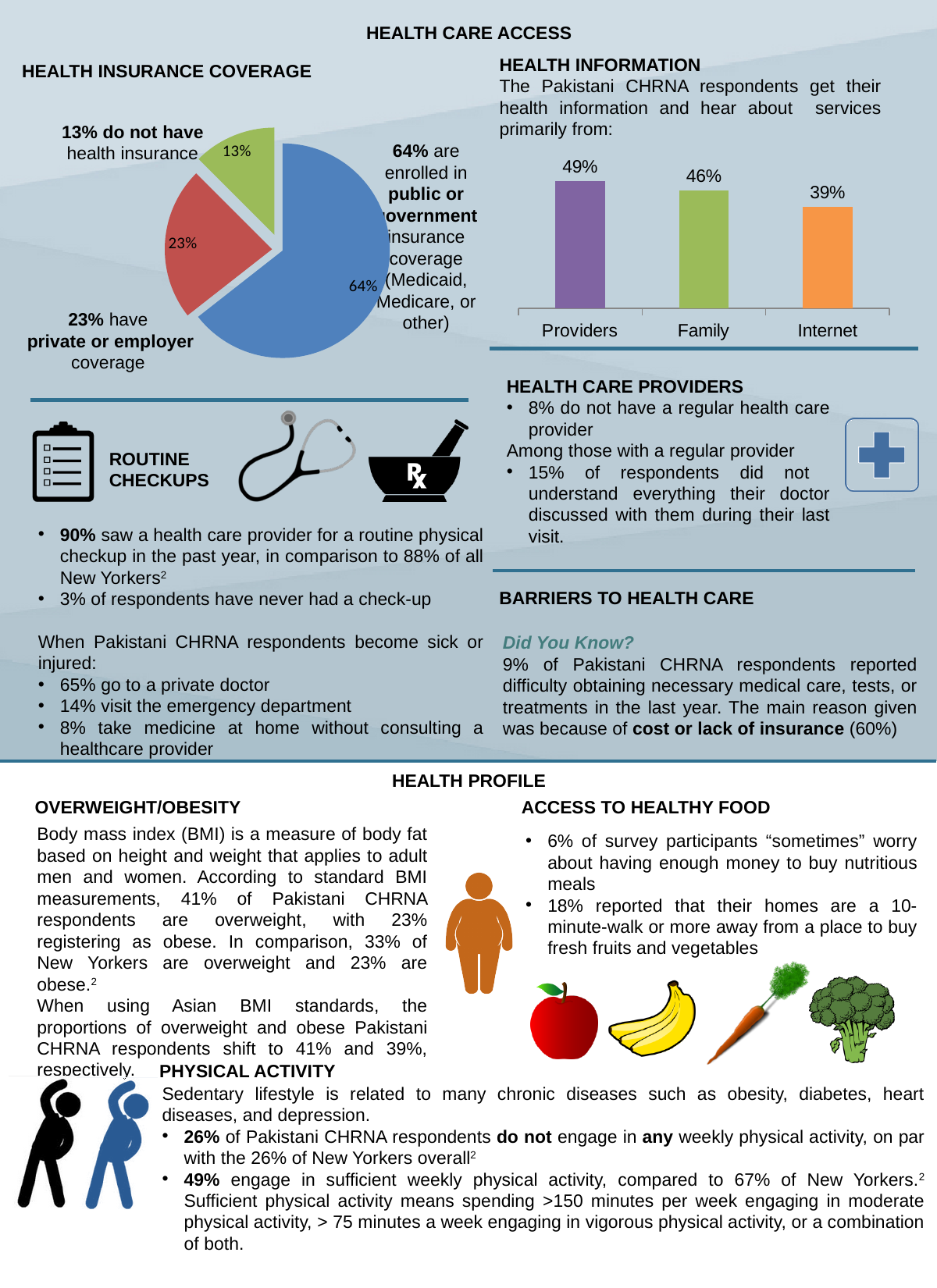
What kind of chart is used in the Health Information section? Bar chart In the Health Information bar chart, what is the difference between the values for Providers and Internet? 10% In the Health Insurance Coverage pie chart, which is larger: the slice for private or employer coverage or the slice for no health insurance? Private or employer coverage In the Health Information bar chart, what is the value for Family? 46% What kind of chart is used in the Health Insurance Coverage section? Pie chart In the Health Information bar chart, which source has the highest value? Providers In the Health Information bar chart, what percentage of respondents get their health information from Providers? 49% In the Health Insurance Coverage pie chart, what share of respondents do not have health insurance? 13% In the Health Information bar chart, what is the value for Internet? 39% In the Health Information bar chart, how many categories are shown? 3 In the Health Insurance Coverage pie chart, what share of respondents are enrolled in public or government insurance coverage? 64% In the Health Information bar chart, which source has the lowest value? Internet